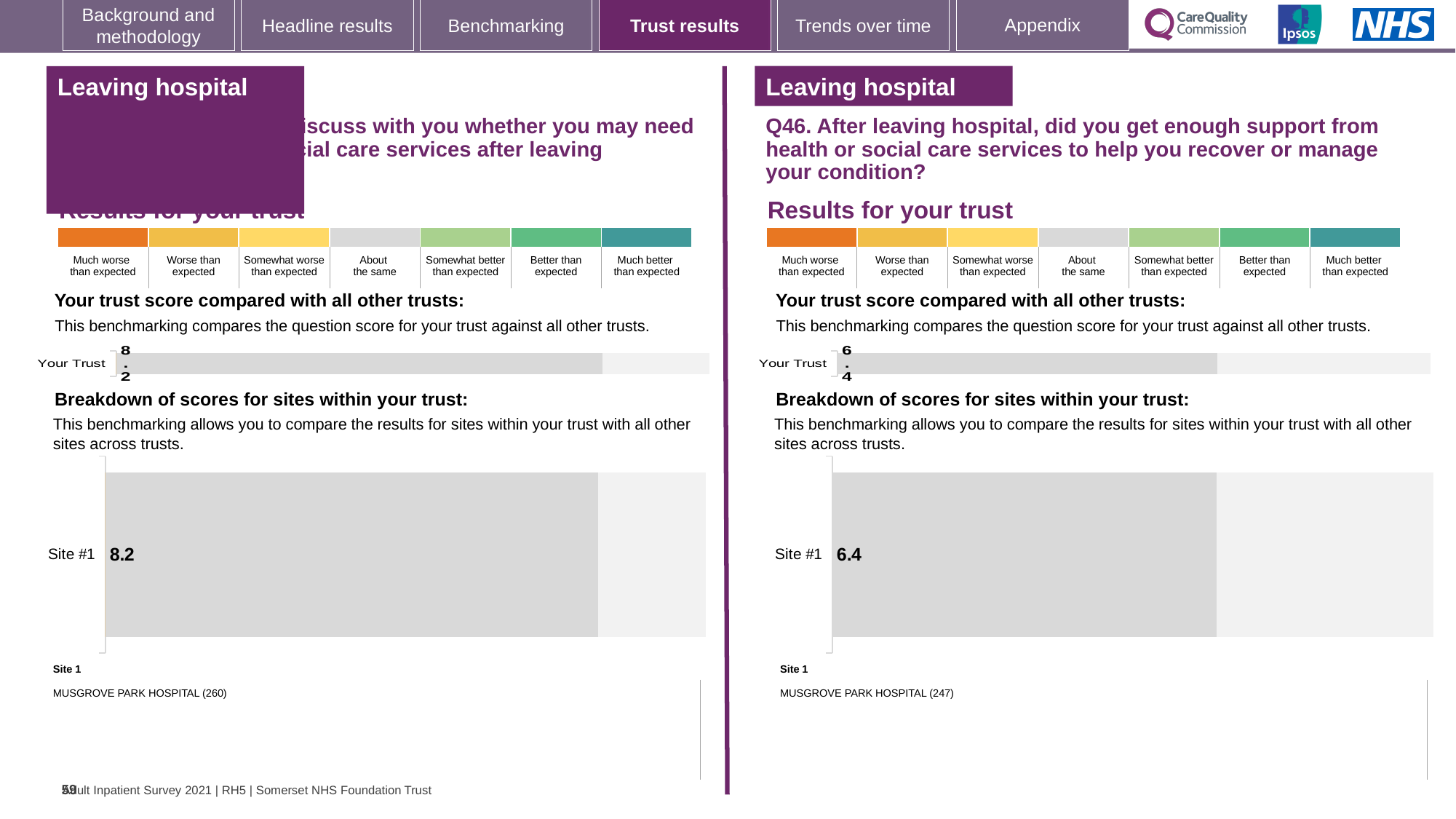
On the right-hand chart (Q46), what is the score shown for Site #1? 6.4 On the left-hand chart, what is the score shown for Site #1? 8.2 Is the Site #1 score on the left-hand chart greater or less than 8? greater What type of chart is used to show the Site #1 score on the left-hand side? Bar chart On the right-hand chart (Q46), what is the score shown for Your Trust? 6.4 What is the difference between the Site #1 score on the left-hand chart and the Site #1 score on the right-hand chart (Q46)? 1.8 On the right-hand chart (Q46), which hospital is listed as Site 1? MUSGROVE PARK HOSPITAL (247) On the left-hand chart, what is the score shown for Your Trust? 8.2 Which is larger: the Your Trust score on the left-hand chart or the Your Trust score on the right-hand chart (Q46)? Left-hand chart How many sites are shown in the site breakdown chart on the right-hand side (Q46)? 1 On the left-hand chart, which hospital is listed as Site 1? MUSGROVE PARK HOSPITAL (260) Is the Your Trust score on the right-hand chart (Q46) greater or less than 7? less